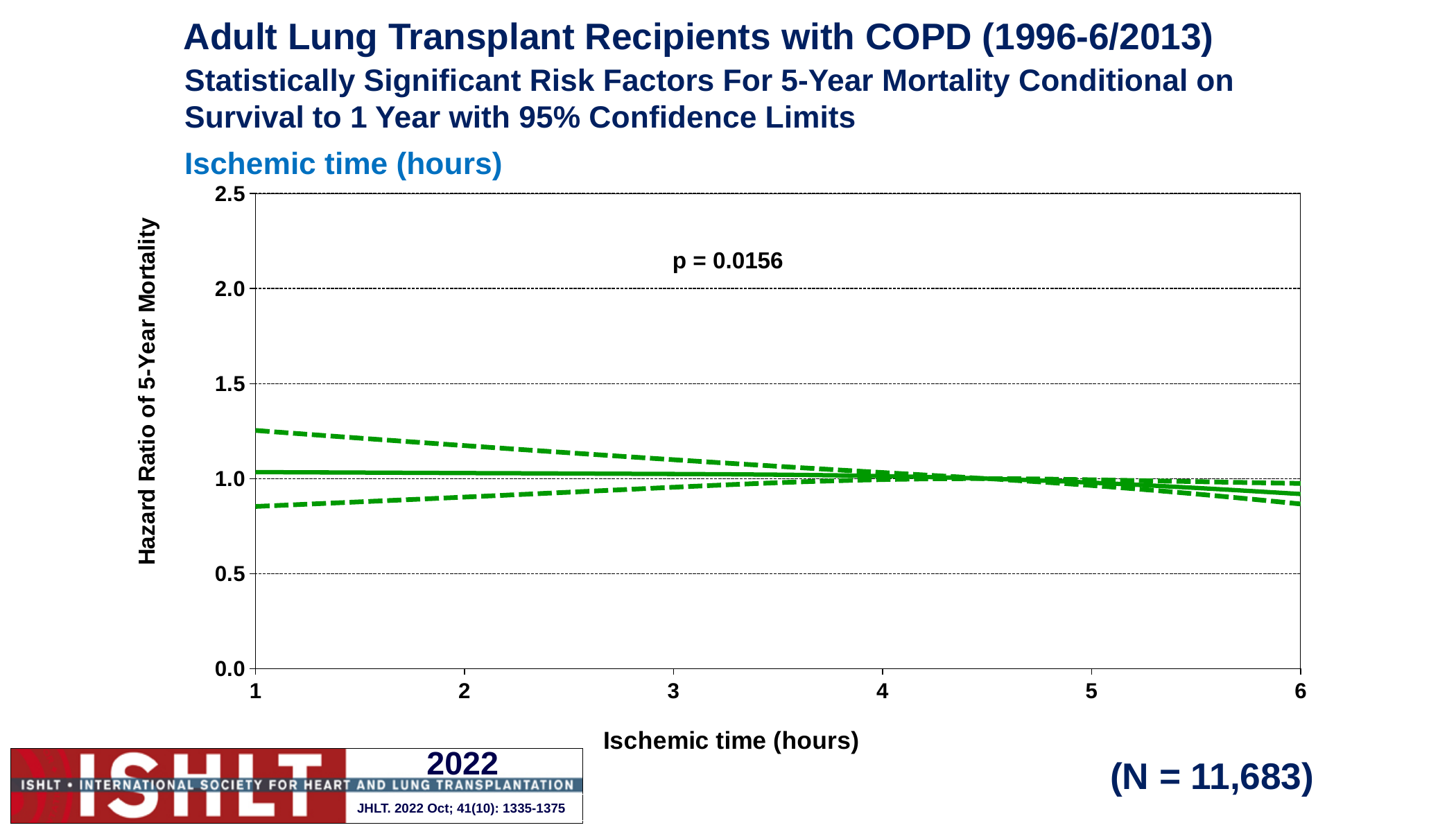
Is the solid hazard ratio line at an ischemic time of 6 hours greater or less than 1.0? less Is the lower confidence limit at an ischemic time of 1 hour greater or less than 1.0? less Is the solid hazard ratio line at an ischemic time of 1 hour greater or less than 0.5? greater Does the upper dashed confidence limit rise or fall as ischemic time increases from 1 to 4 hours? fall What sample size (N) is shown on the slide? N = 11,683 Does the solid hazard ratio line rise or fall as ischemic time increases from 1 to 6 hours? fall What kind of chart is shown on the slide? line chart What p-value is printed on the chart? p = 0.0156 Does the lower dashed confidence limit rise or fall as ischemic time increases from 1 to 4 hours? rise